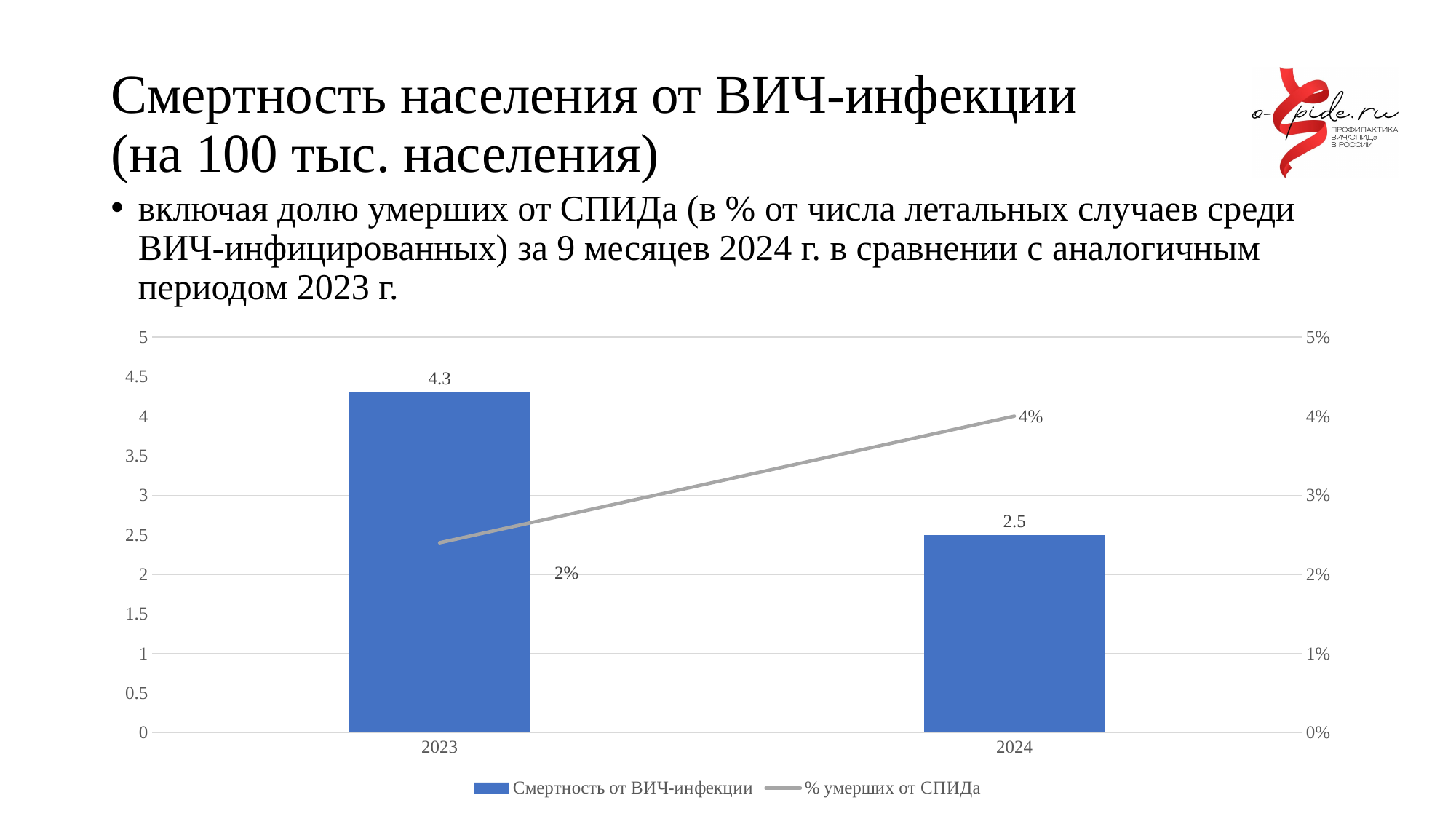
What is the value of % умерших от СПИДа for 2023? 2% Is the value of % умерших от СПИДа larger in 2023 or in 2024? 2024 How many series does the chart legend list? 2 How many years are shown on the x axis of the chart? 2 Which series is drawn as a line in the chart? % умерших от СПИДа Does Смертность от ВИЧ-инфекции rise or fall from 2023 to 2024? fall Which year has the higher value of Смертность от ВИЧ-инфекции? 2023 What is the value of % умерших от СПИДа for 2024? 4% What is the value of Смертность от ВИЧ-инфекции for 2024? 2.5 Which year has the lower value of % умерших от СПИДа? 2023 By how much did Смертность от ВИЧ-инфекции decrease from 2023 to 2024? 1.8 What is the value of Смертность от ВИЧ-инфекции for 2023? 4.3